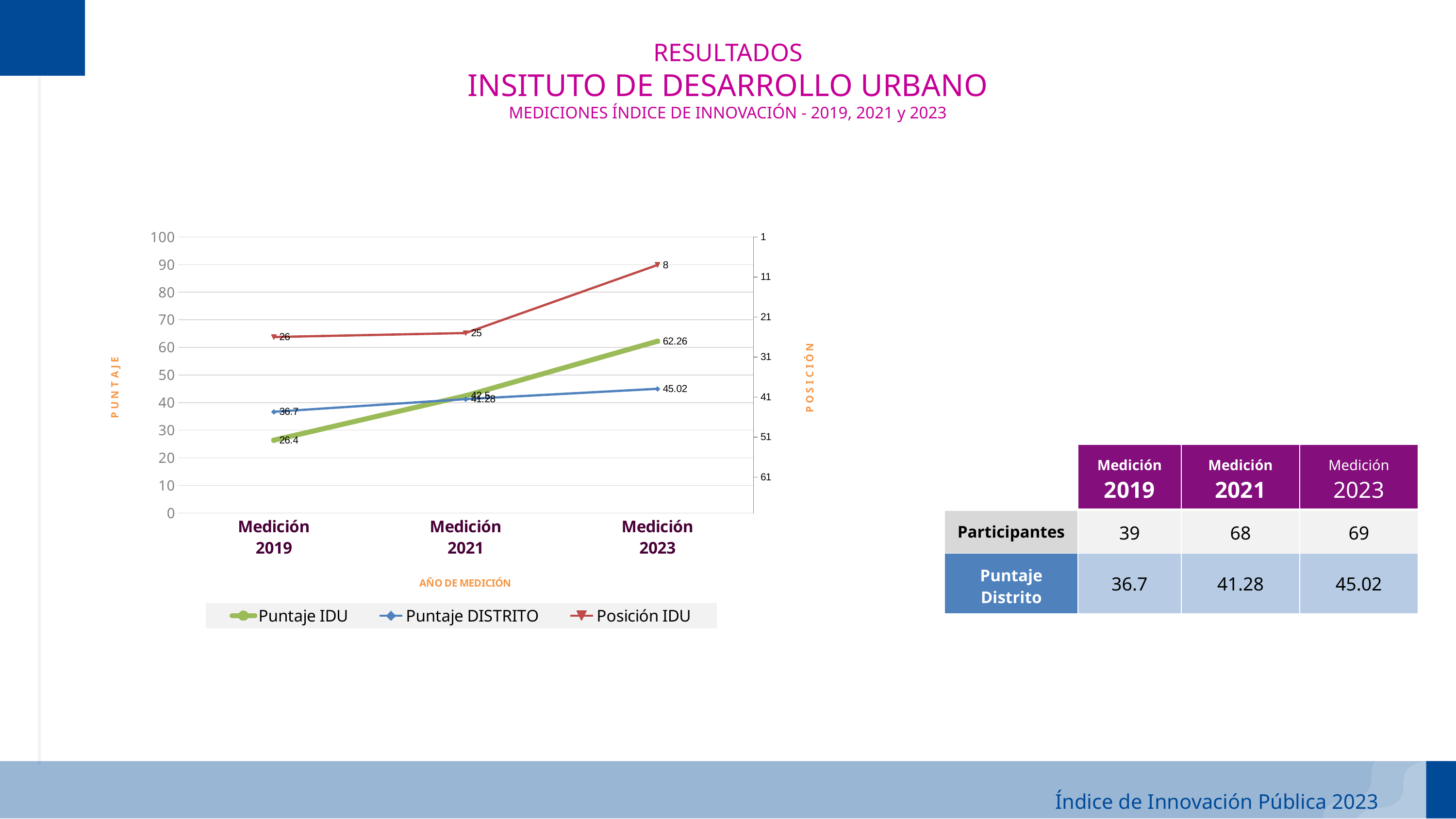
Which is larger for Medición 2019, the Puntaje IDU or the Puntaje DISTRITO? Puntaje DISTRITO What is the Posición IDU value for Medición 2019? 26 What is the Posición IDU value for Medición 2023? 8 What is the Puntaje IDU value for Medición 2023? 62.26 In which measurement year is the Puntaje IDU highest? Medición 2023 What is the Puntaje IDU value for Medición 2019? 26.4 What is the difference between the Puntaje IDU and the Puntaje DISTRITO for Medición 2023? 17.24 What kind of chart is shown on the slide? Line chart How many measurement years are shown on the x axis of the chart? 3 How many series does the chart legend list? 3 What is the Puntaje DISTRITO value for Medición 2021? 41.28 In which measurement year is the Puntaje DISTRITO lowest? Medición 2019